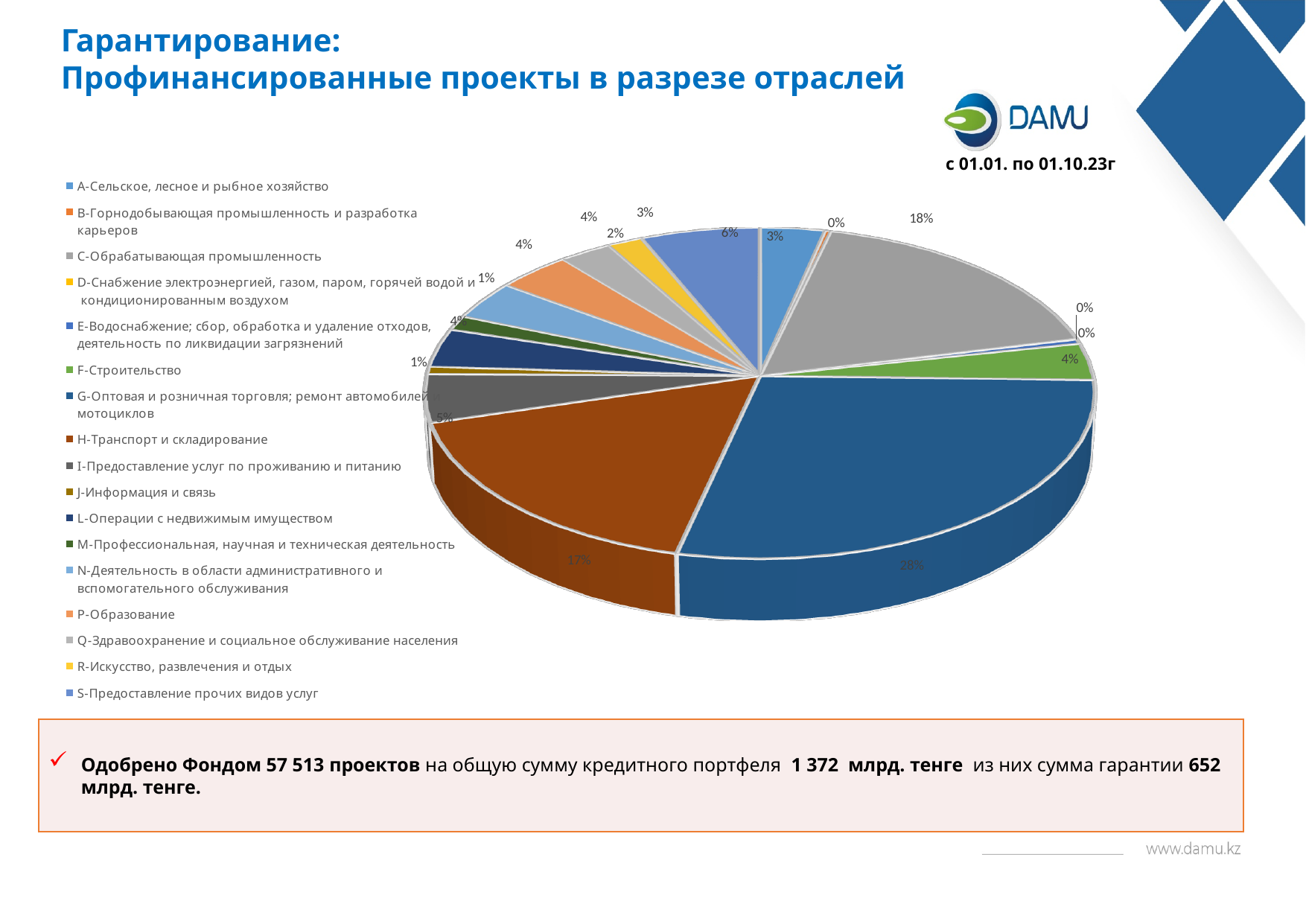
What is the value shown for H-Транспорт и складирование? 17% Which is larger: the share for C-Обрабатывающая промышленность or for H-Транспорт и складирование? C-Обрабатывающая промышленность What is the value shown for C-Обрабатывающая промышленность? 18% What is the value shown for S-Предоставление прочих видов услуг? 6% What is the difference in percentage points between G-Оптовая и розничная торговля and H-Транспорт и складирование? 11 What kind of chart is shown on the slide? pie chart Which sector has the largest share of the pie? G-Оптовая и розничная торговля; ремонт автомобилей и мотоциклов What is the value shown for A-Сельское, лесное и рыбное хозяйство? 3% What period does the chart cover, according to the text above it? с 01.01. по 01.10.23г How many sectors are listed in the legend? 17 What is the value shown for I-Предоставление услуг по проживанию и питанию? 5% What share of the pie does G-Оптовая и розничная торговля; ремонт автомобилей и мотоциклов have? 28%